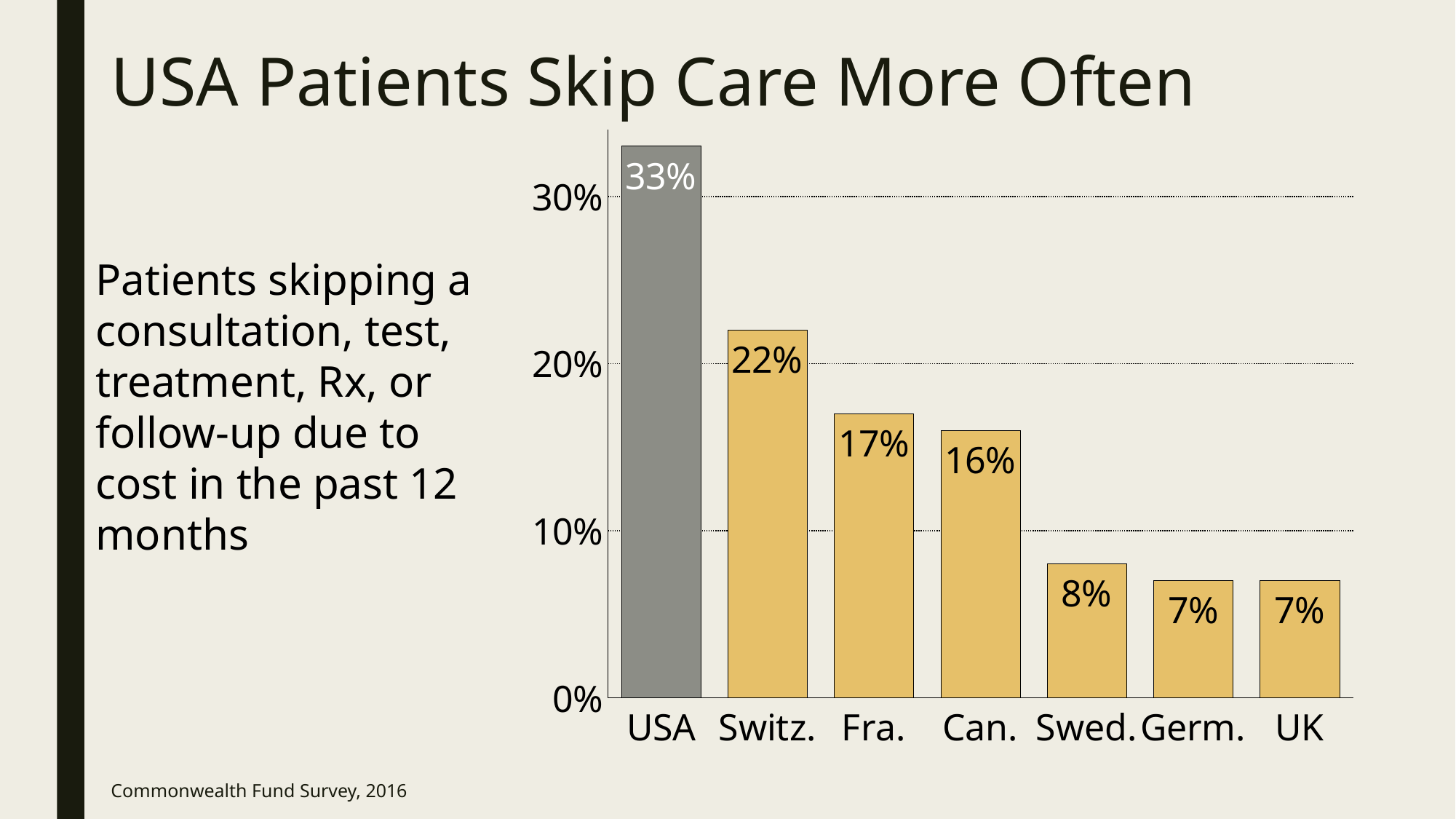
What is the value shown for Switz.? 22% What is the value shown for Can.? 16% What is the value shown for Swed.? 8% Is the value for Swed. greater or less than 10%? less Which bar is shown in a different colour (grey) from the others? USA How many countries are shown in the chart? 7 What is the difference between the USA value and the Switz. value? 11 percentage points Which country has the highest share of patients skipping care due to cost? USA What percentage of patients in the USA skipped care due to cost? 33% What is the difference between the Fra. value and the Germ. value? 10 percentage points Which is larger, the value for Fra. or the value for Can.? Fra. What kind of chart is shown on the slide? Bar chart